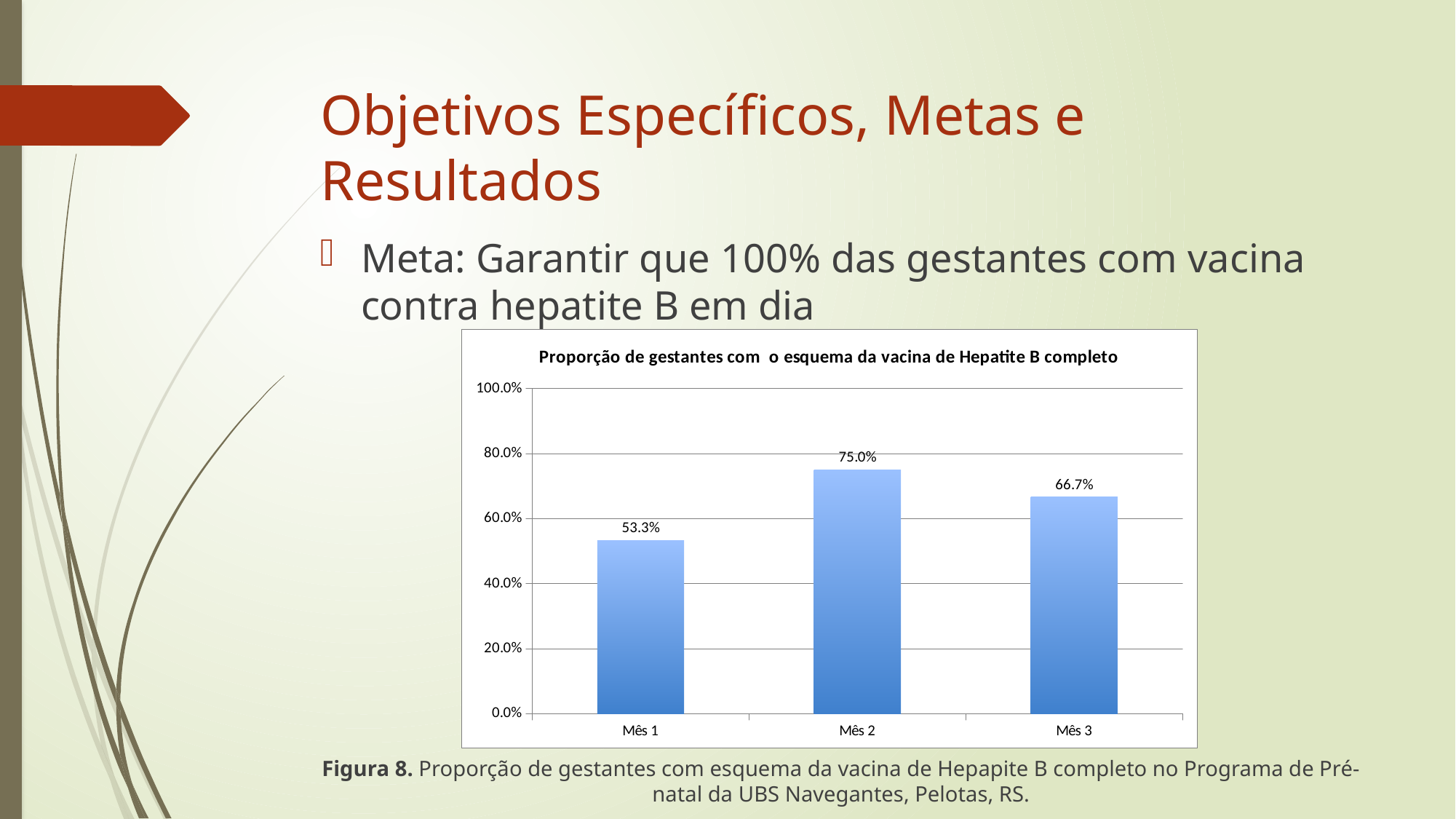
Which month has the highest proportion? Mês 2 What is the value for Mês 2? 75.0% What is the value for Mês 3? 66.7% What is the value for Mês 1? 53.3% How many months are shown on the x axis? 3 What is the difference between the values for Mês 2 and Mês 1? 21.7% What is the title of the chart? Proporção de gestantes com o esquema da vacina de Hepatite B completo Which month has the lowest proportion? Mês 1 What kind of chart is shown on the slide? bar chart What is the difference between the values for Mês 2 and Mês 3? 8.3% Which is larger, the value for Mês 3 or the value for Mês 1? Mês 3 Is the value for Mês 1 greater or less than 60.0%? less